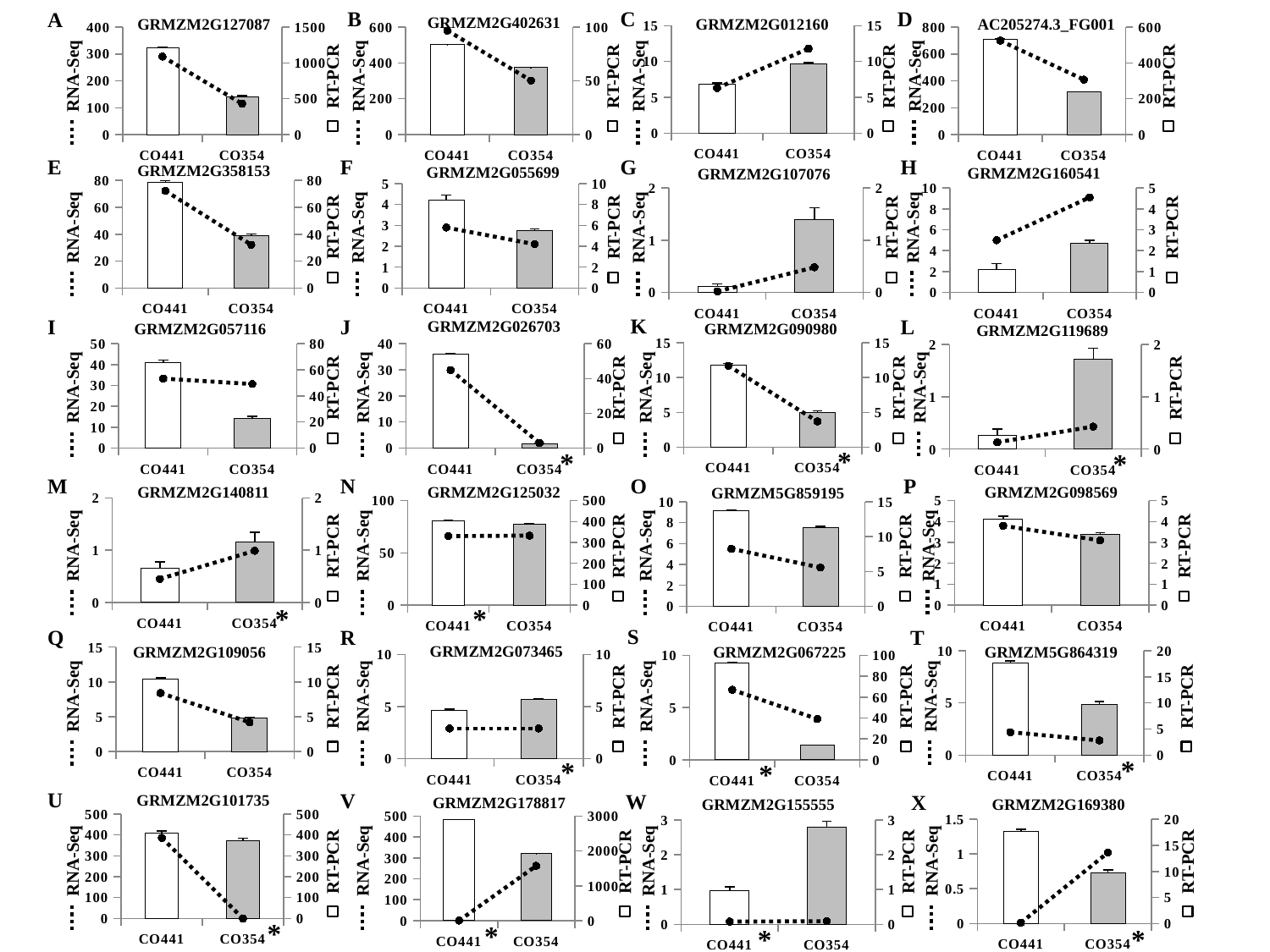
In chart E (GRMZM2G358153), is the RNA-Seq bar for CO441 greater or less than 60? greater In chart K (GRMZM2G090980), do the RNA-Seq bars rise or fall from CO441 to CO354? fall How many categories are shown on the x axis of chart A (GRMZM2G127087)? 2 In chart C (GRMZM2G012160), which category has the taller RNA-Seq bar, CO441 or CO354? CO354 In chart A (GRMZM2G127087), which category has the taller RNA-Seq bar, CO441 or CO354? CO441 What kind of chart is chart A (GRMZM2G127087)? bar chart with a line overlay What is the title of chart D, in the top right of the slide? AC205274.3_FG001